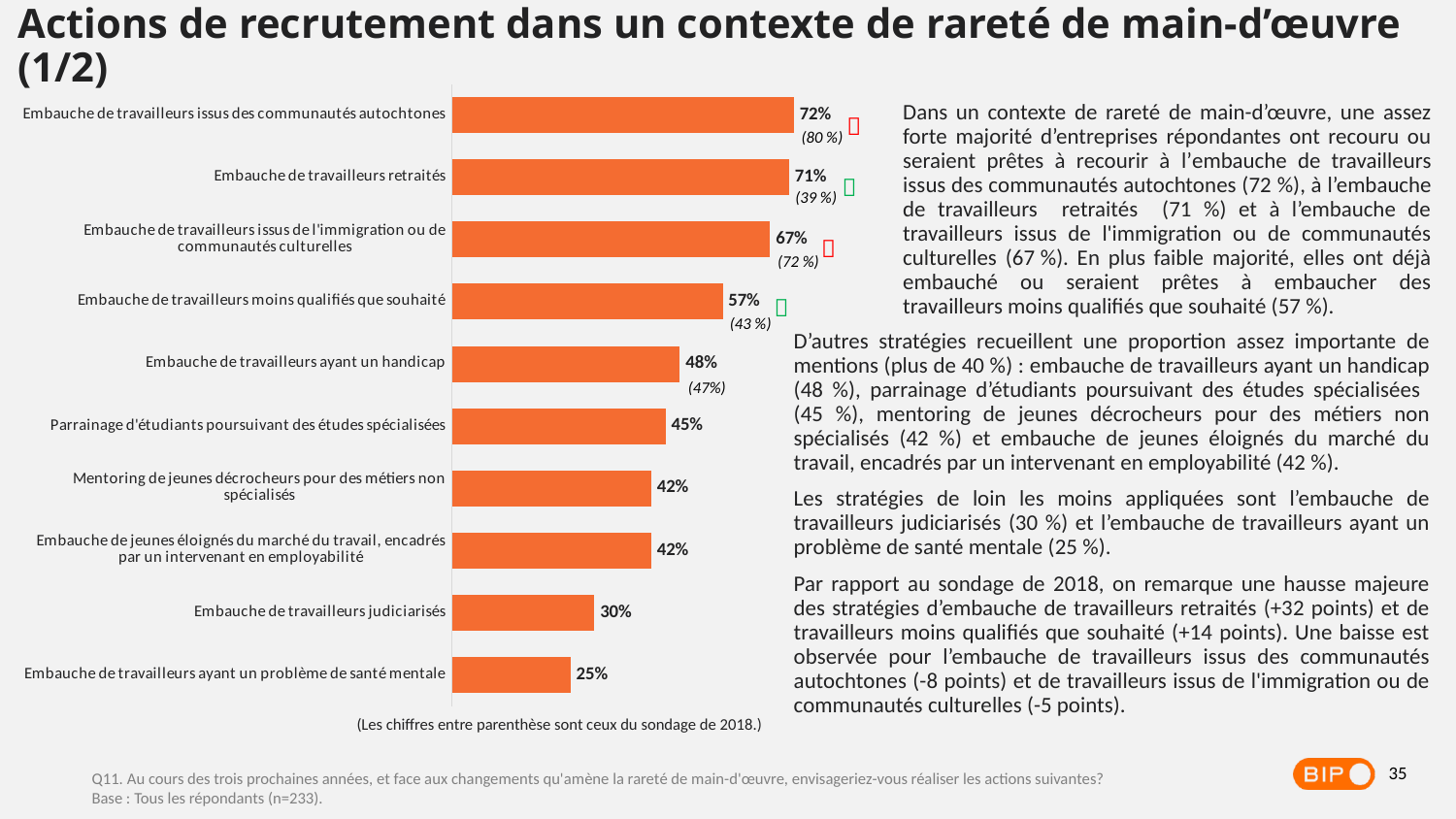
What colour are the bars in the chart? Orange What is the value for "Embauche de travailleurs ayant un handicap"? 48% Which category has the lowest value in the chart? Embauche de travailleurs ayant un problème de santé mentale Which category has the highest value in the chart? Embauche de travailleurs issus des communautés autochtones What is the 2018 survey value shown in parentheses for "Embauche de travailleurs issus des communautés autochtones"? 80 % What is the difference between the current value (71%) and the 2018 value (39 %) for "Embauche de travailleurs retraités"? 32 percentage points What is the difference between the values for "Embauche de travailleurs issus des communautés autochtones" (72%) and "Embauche de travailleurs ayant un problème de santé mentale" (25%)? 47 percentage points What type of chart is shown on the slide? Bar chart How many categories are plotted in the chart? 10 What percentage is shown for "Embauche de travailleurs retraités"? 71% Which is larger: the value for "Parrainage d'étudiants poursuivant des études spécialisées" or the value for "Embauche de travailleurs judiciarisés"? Parrainage d'étudiants poursuivant des études spécialisées What value is shown for "Embauche de travailleurs judiciarisés"? 30%